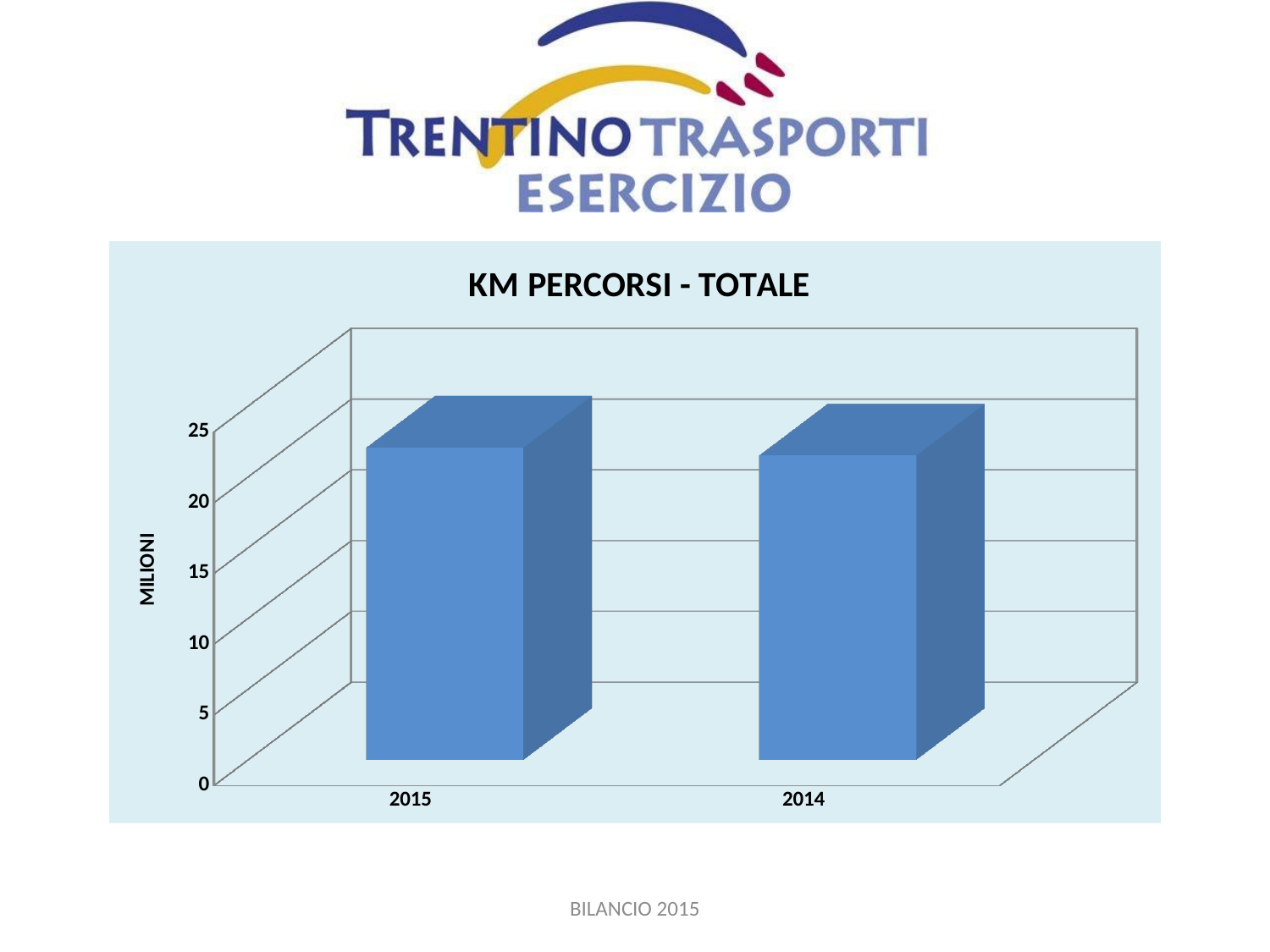
What is the label on the vertical axis of the chart? MILIONI Is the value for 2015 greater or less than 25? less What kind of chart is shown on the slide? bar chart Is the value for 2014 greater or less than 25? less Is the value for 2014 greater or less than 20? greater How many categories are shown on the x axis of the chart? 2 What is the title of the chart? KM PERCORSI - TOTALE